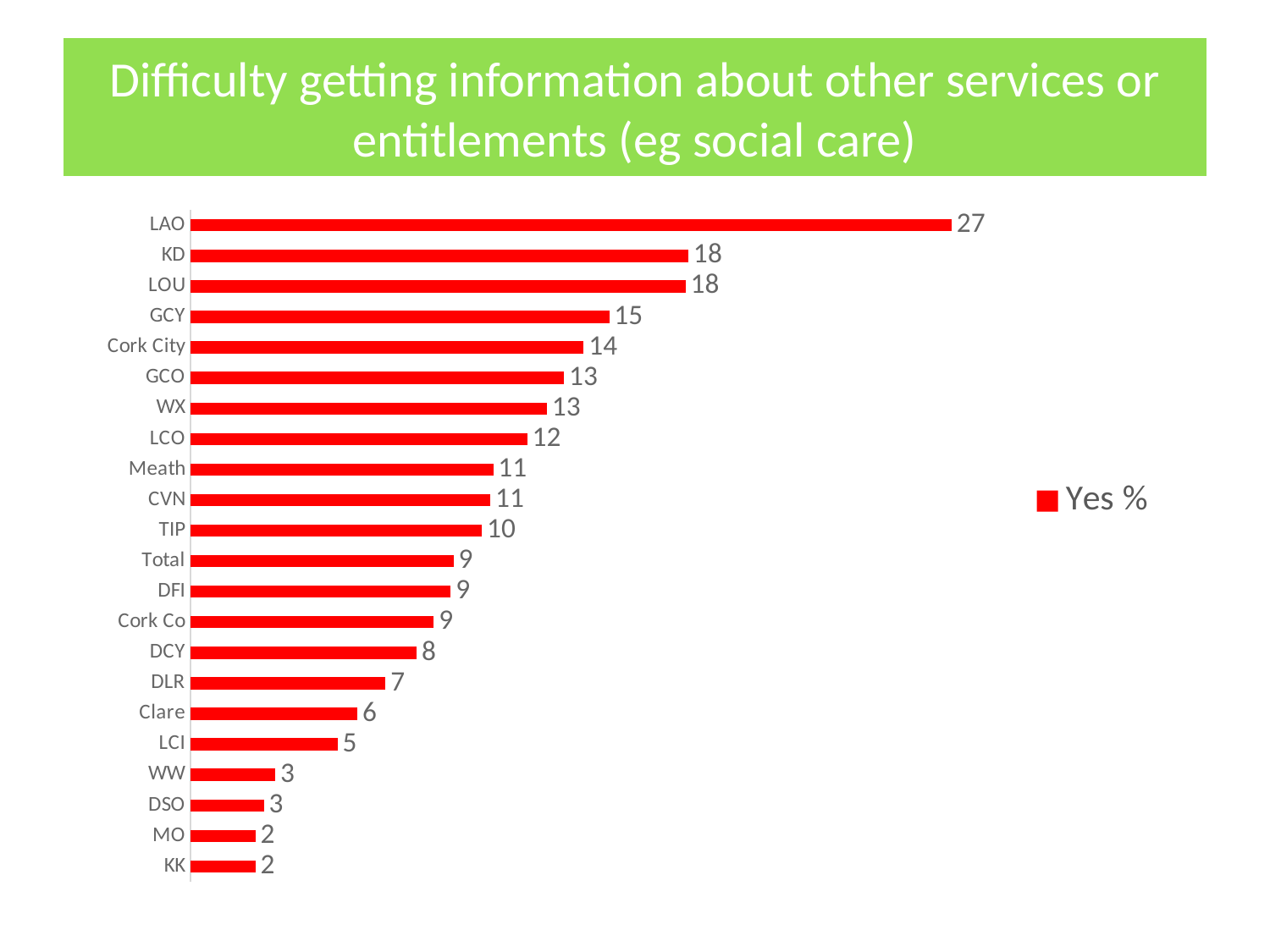
What is the value for LAO? 27 Which has a larger value, DLR or TIP? TIP What is the value for Total? 9 What kind of chart is shown on the slide? Bar chart Which category has the highest value? LAO Which has a larger value, LOU or LCO? LOU What is the difference between the values for GCY and DCY? 7 How many categories are shown in the chart? 22 What is the value for Clare? 6 What series does the legend list? Yes % What is the difference between the values for LAO and KD? 9 What is the value for Cork City? 14